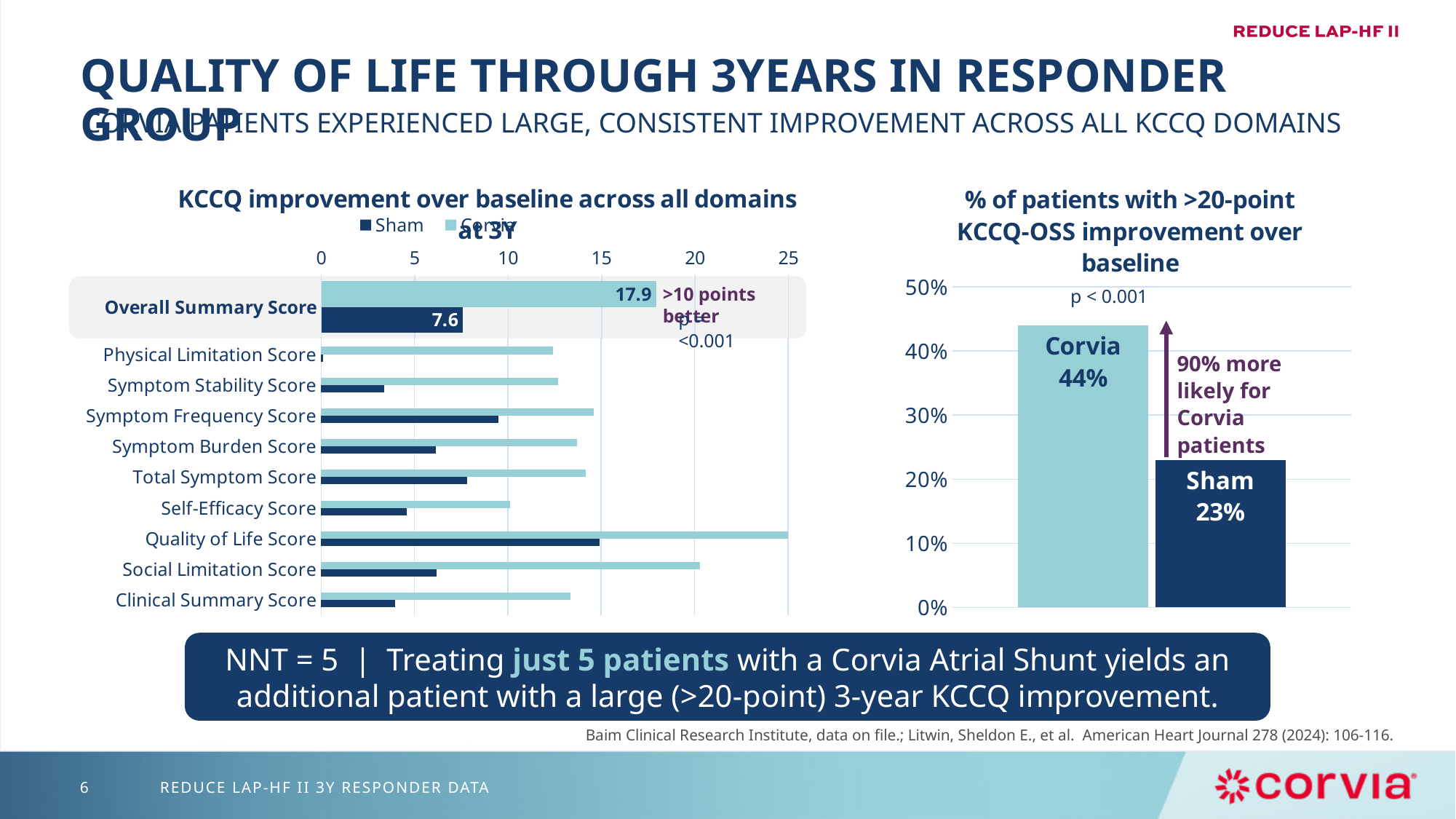
What kind of chart is the chart titled 'KCCQ improvement over baseline across all domains'? Bar chart In the chart titled 'KCCQ improvement over baseline across all domains', how many series does the legend list? 2 In the chart titled 'KCCQ improvement over baseline across all domains', what is the Sham value for Overall Summary Score? 7.6 In the chart titled 'KCCQ improvement over baseline across all domains', what is the Corvia value for Overall Summary Score? 17.9 In the chart titled 'KCCQ improvement over baseline across all domains', which series has the larger value for Symptom Stability Score, Sham or Corvia? Corvia In the chart titled 'KCCQ improvement over baseline across all domains', how many score categories are listed on the vertical axis? 10 In the chart titled 'KCCQ improvement over baseline across all domains', what is the difference between the Corvia and Sham values for Overall Summary Score? 10.3 In the chart titled '% of patients with >20-point KCCQ-OSS improvement over baseline', what is the difference between the Corvia and Sham values? 21 percentage points In the chart titled 'KCCQ improvement over baseline across all domains', is the Sham value for Physical Limitation Score greater or less than 5? less In the chart titled 'KCCQ improvement over baseline across all domains', is the Corvia value for Quality of Life Score greater or less than 20? greater In the chart titled '% of patients with >20-point KCCQ-OSS improvement over baseline', what is the value for Sham? 23% In the chart titled '% of patients with >20-point KCCQ-OSS improvement over baseline', what is the value for Corvia? 44%